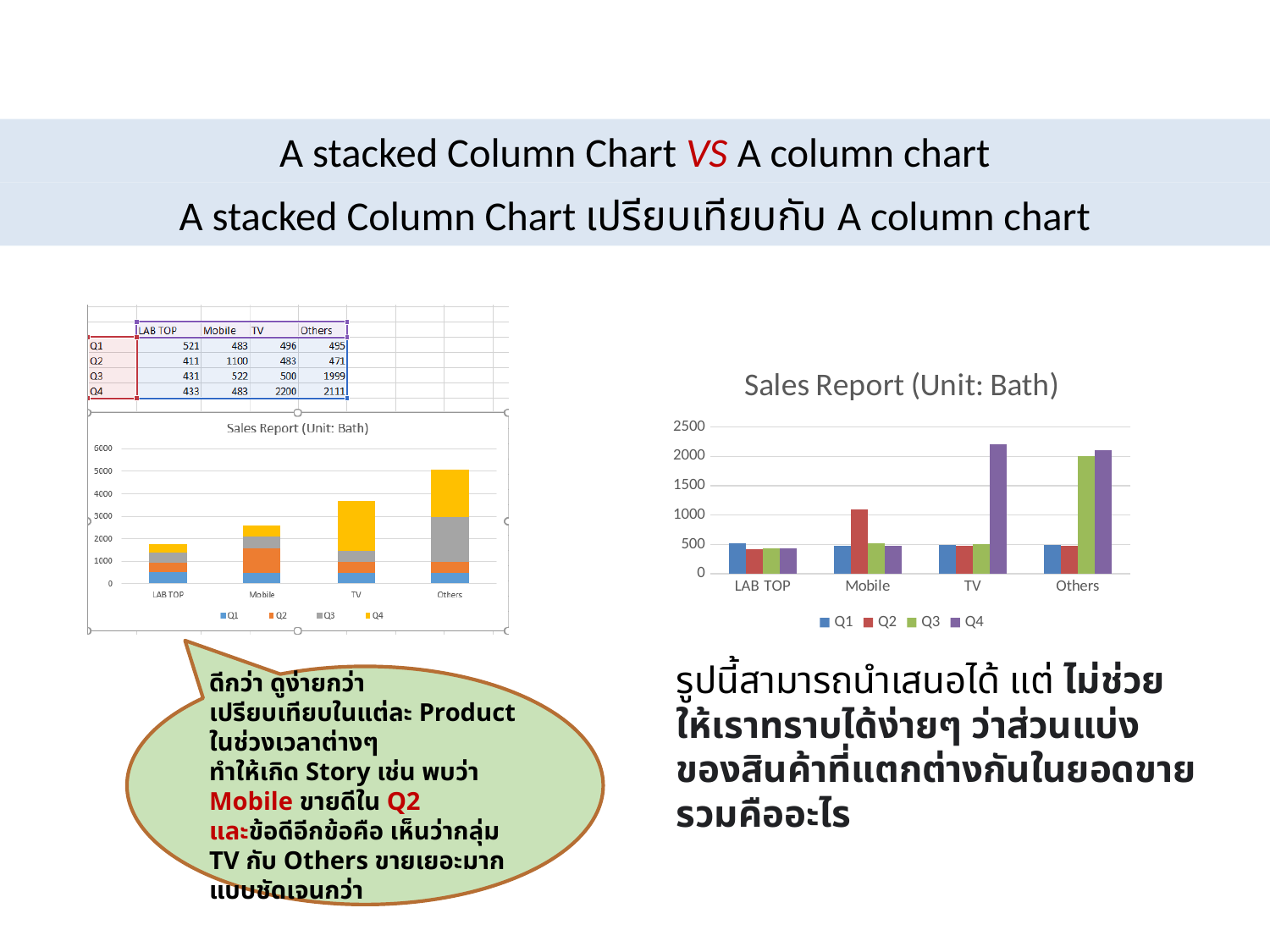
In the right-hand chart, is the Q2 value for Mobile greater or less than 1000? greater In the right-hand chart, which category has the highest Q2 value? Mobile What kind of chart is the chart on the left side of the slide? Stacked bar chart In the left-hand stacked chart, which category has the shortest stacked bar? LAB TOP How many series does the legend of the right-hand chart list? 4 In the right-hand chart, is the Q4 value for TV greater or less than 2000? greater In the left-hand stacked chart, which category has the tallest stacked bar? Others How many product categories are shown on the x axis of the right-hand chart? 4 What is the title of the right-hand chart? Sales Report (Unit: Bath) In the left-hand stacked chart, is the total stacked bar for TV greater or less than 3000? greater In the right-hand chart, which category has the highest Q3 value? Others What kind of chart is the chart on the right side of the slide? Bar chart